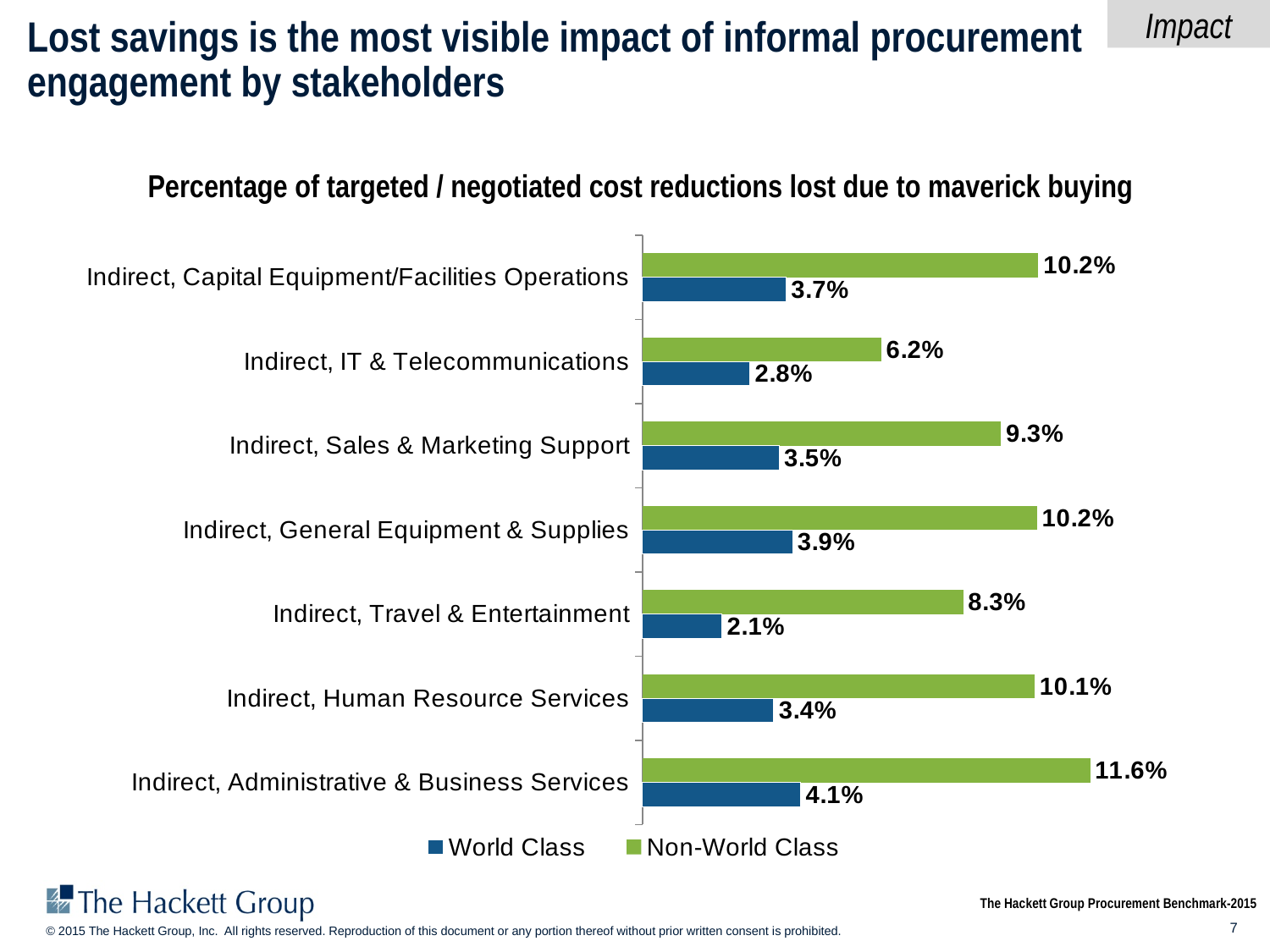
Which category has the highest Non-World Class value? Indirect, Administrative & Business Services How many series does the legend list? 2 What is the title of the chart? Percentage of targeted / negotiated cost reductions lost due to maverick buying Which is larger: the World Class value for Indirect, General Equipment & Supplies or the World Class value for Indirect, Sales & Marketing Support? Indirect, General Equipment & Supplies What kind of chart is shown on the slide? Bar chart How many categories are shown in the chart? 7 What is the Non-World Class value for Indirect, Administrative & Business Services? 11.6% What is the difference between the Non-World Class and World Class values for Indirect, Human Resource Services? 6.7% What is the Non-World Class value for Indirect, IT & Telecommunications? 6.2% What is the World Class value for Indirect, Travel & Entertainment? 2.1% Which colour represents the Non-World Class series? Green Which category has the lowest World Class value? Indirect, Travel & Entertainment